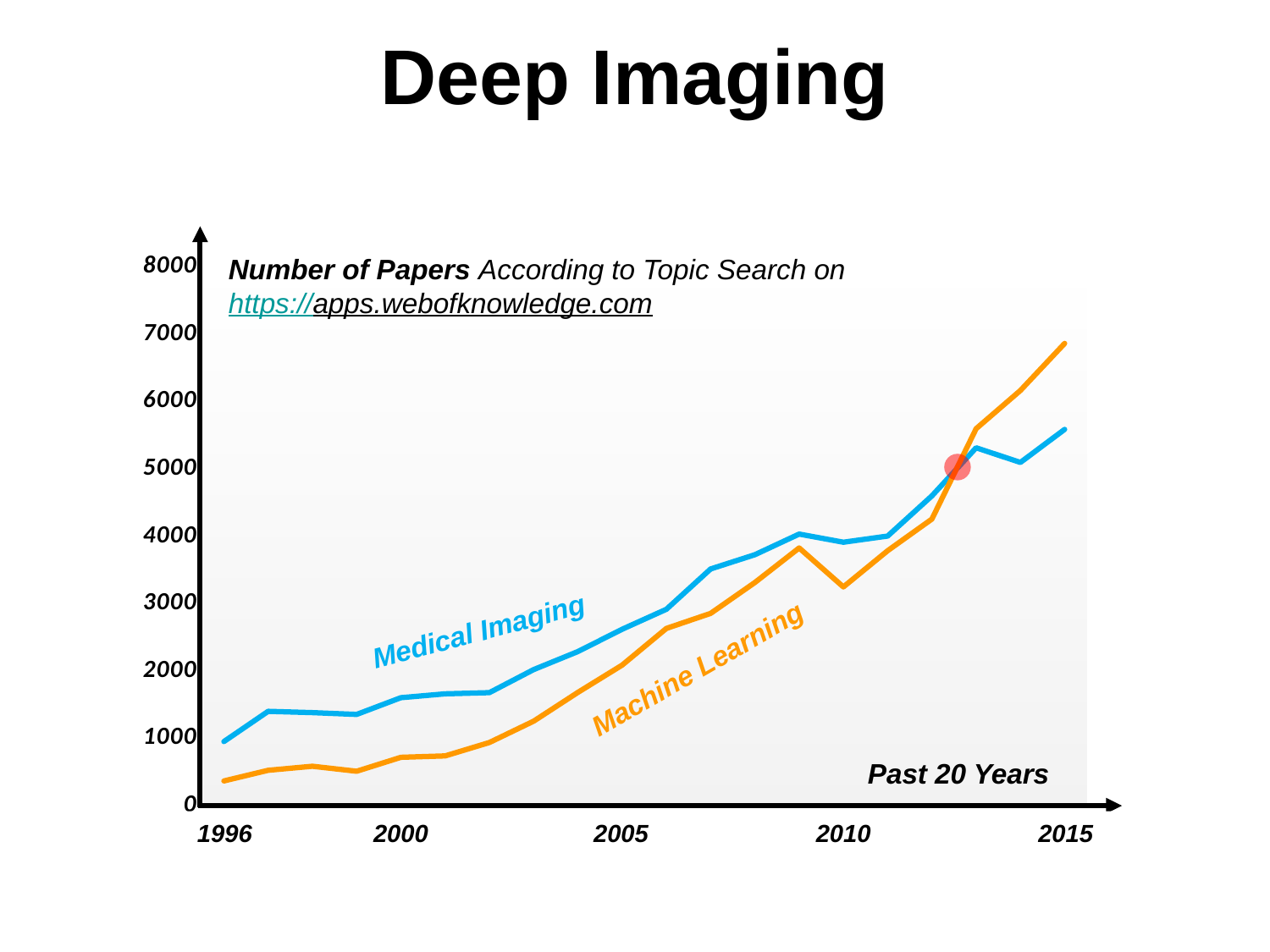
In 2005, which series has the higher value, Medical Imaging or Machine Learning? Medical Imaging How many series are plotted on the chart? 2 In 2015, which series has the higher value, Medical Imaging or Machine Learning? Machine Learning Does the Machine Learning series generally rise or fall from 1996 to 2015? Rise Is the value for Machine Learning in 2000 greater or less than 1000? less Which series is plotted in orange? Machine Learning Is the value for Medical Imaging in 2015 greater or less than 6000? less What kind of chart is shown on the slide? Line chart Is the value for Machine Learning in 2015 greater or less than 6000? greater Which series is plotted in blue? Medical Imaging